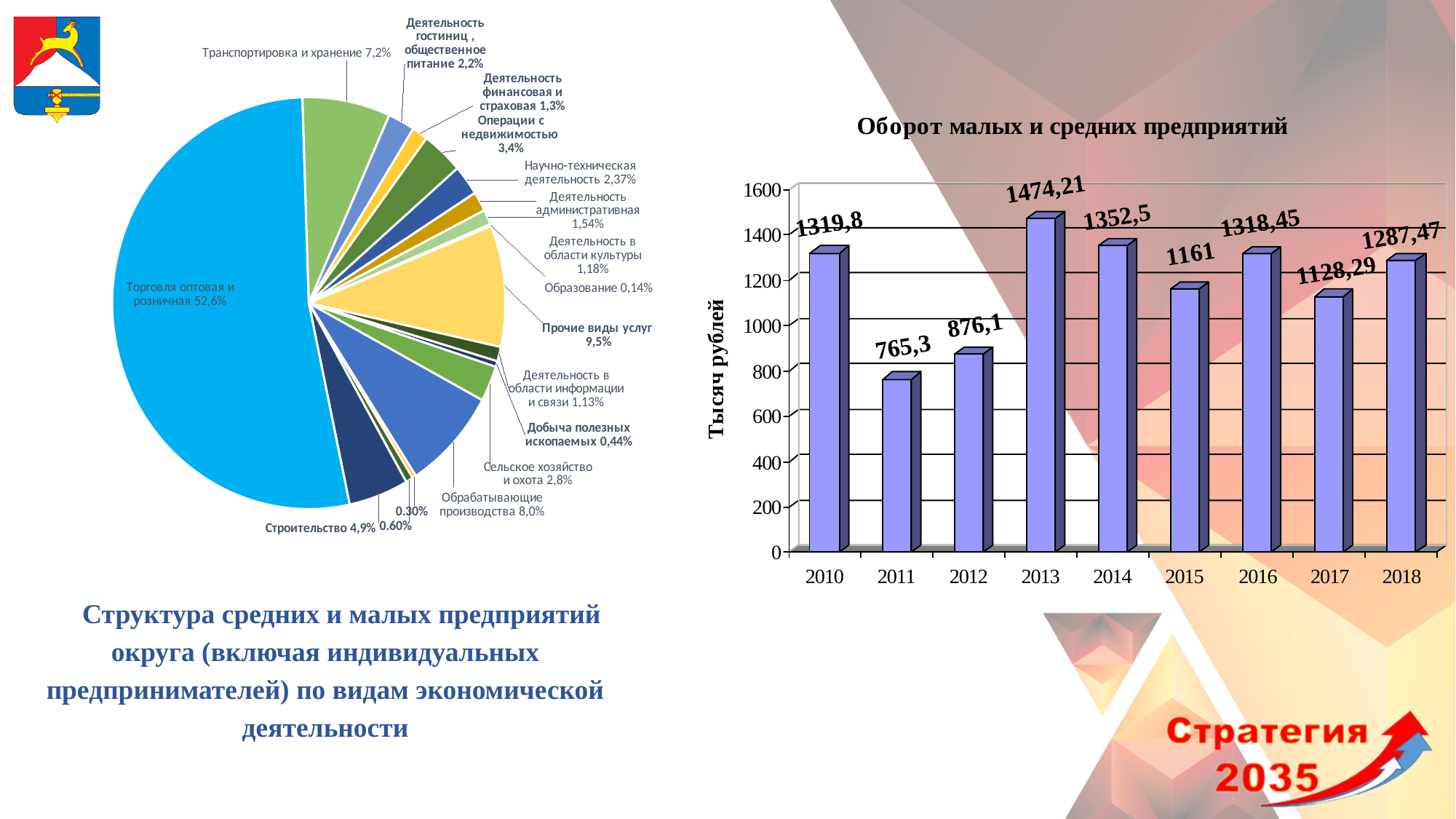
On the chart 'Оборот малых и средних предприятий', what is the value for 2013? 1474,21 On the chart 'Оборот малых и средних предприятий', which year has the lowest value? 2011 What kind of chart is 'Оборот малых и средних предприятий'? bar chart On the chart 'Оборот малых и средних предприятий', how many years are shown on the x axis? 9 On the chart 'Оборот малых и средних предприятий', what is the label of the vertical axis? Тысяч рублей On the chart 'Оборот малых и средних предприятий', what is the difference between the values for 2013 and 2011? 708,91 On the pie chart on the left, what is the value for 'Обрабатывающие производства'? 8,0% On the pie chart on the left, what share does 'Торговля оптовая и розничная' have? 52,6% On the pie chart on the left, which is larger, 'Транспортировка и хранение' or 'Строительство'? Транспортировка и хранение On the chart 'Оборот малых и средних предприятий', which year has the highest value? 2013 On the chart 'Оборот малых и средних предприятий', what is the value for 2017? 1128,29 On the chart 'Оборот малых и средних предприятий', which is larger, the value for 2014 or the value for 2016? 2014